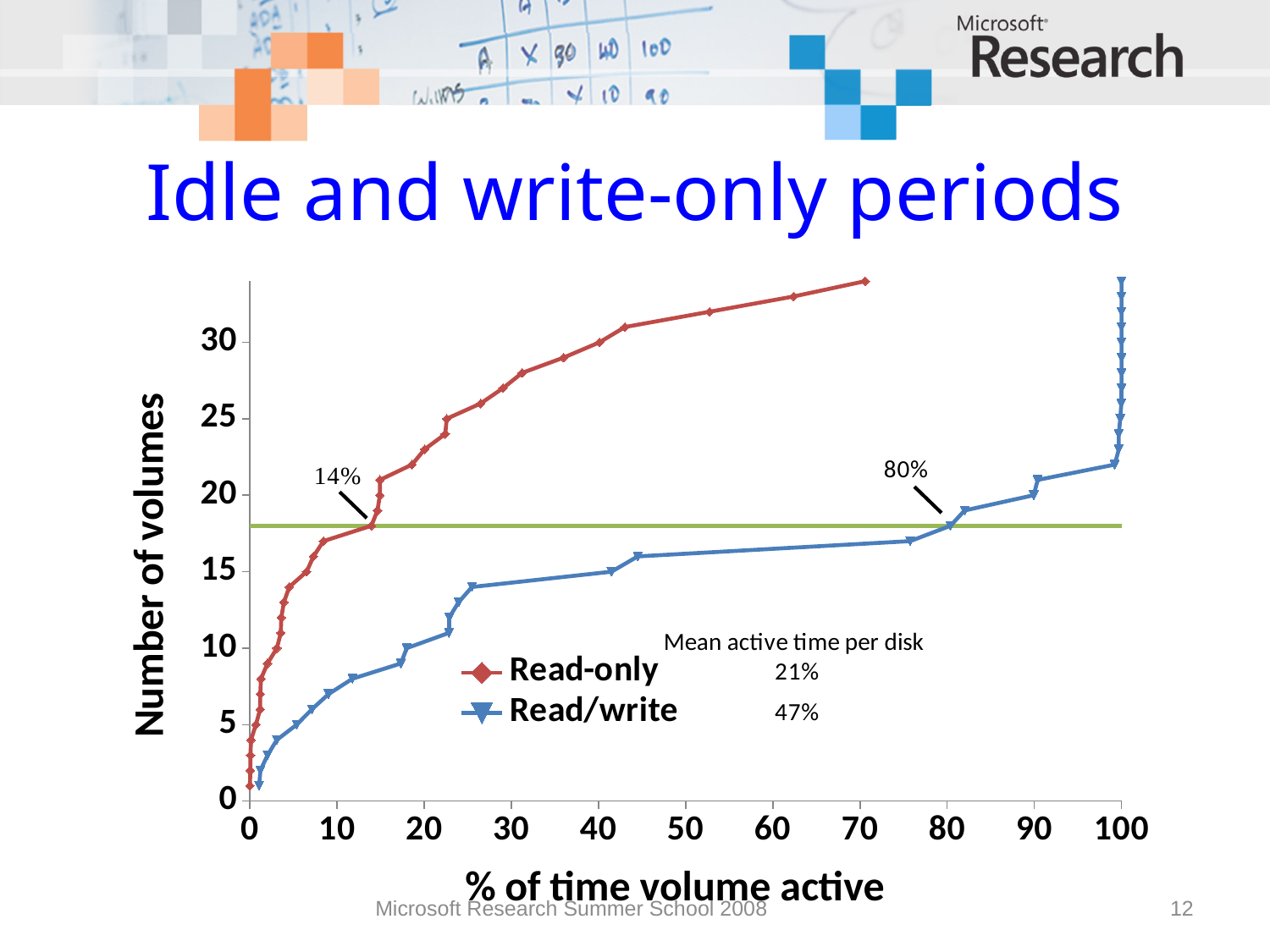
What are the two series named in the legend? Read-only and Read/write What percentage is annotated where the Read-only curve crosses the green horizontal line? 14% Which series has the higher mean active time per disk, Read-only or Read/write? Read/write Do the number of volumes for the Read-only series rise or fall as % of time volume active increases? rise What is the mean active time per disk for the Read/write series? 47% What is the mean active time per disk for the Read-only series? 21% How many series does the legend list? 2 What is the difference between the mean active time per disk of Read/write and Read-only? 26% Is the number of volumes for the Read/write series at 60% of time volume active greater or less than 20? less What kind of chart is shown on the slide? line chart What is the label of the x axis? % of time volume active What percentage is annotated where the Read/write curve crosses the green horizontal line? 80%